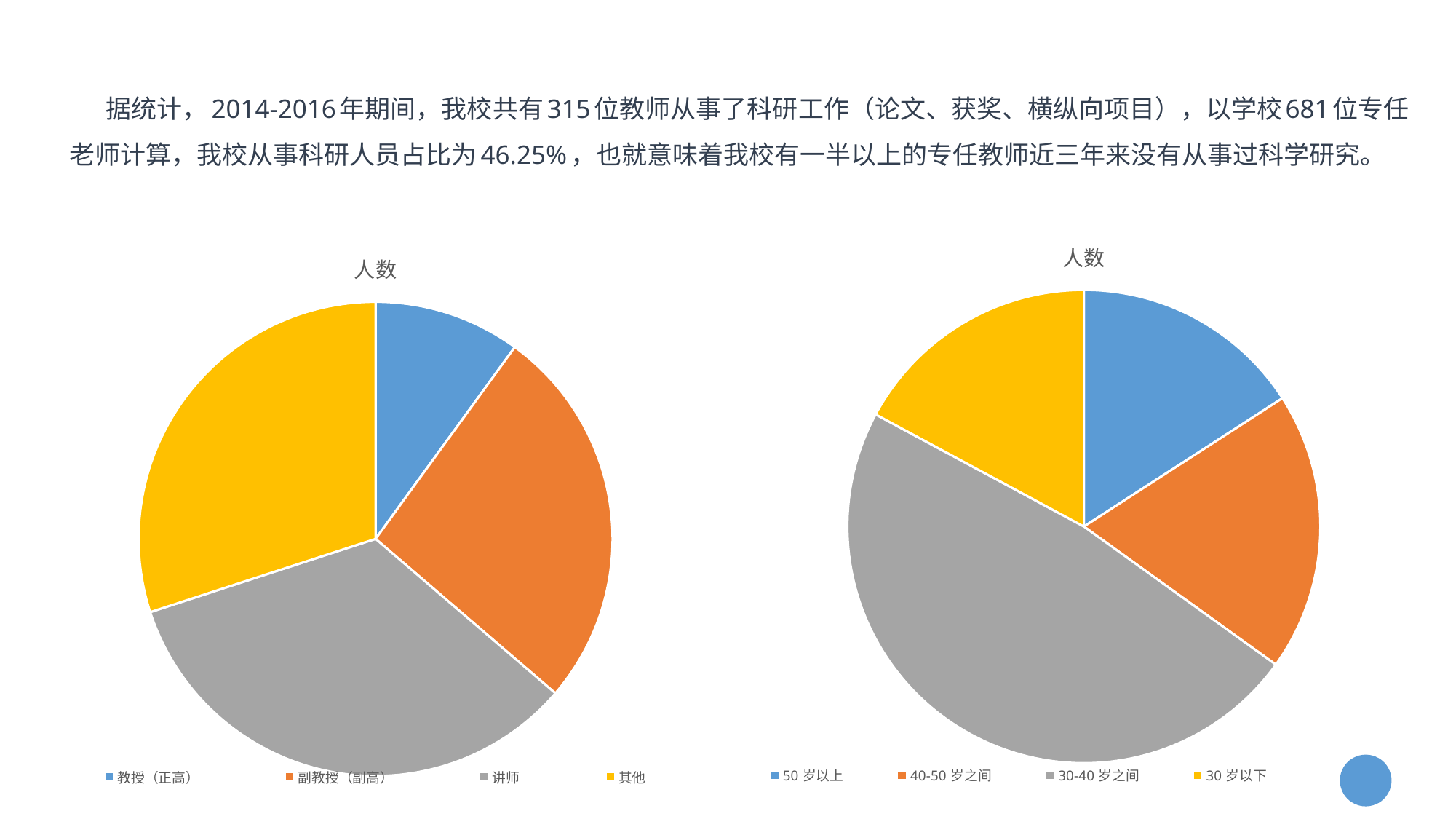
In the left pie chart, how many slices (categories) are there? 4 In the left pie chart, which slice is larger: 副教授（副高） or 教授（正高）? 副教授（副高） In the right pie chart, which category is shown in gray? 30-40 岁之间 What kind of chart is the right chart on the slide? pie chart In the right pie chart, how many slices (categories) are there? 4 In the left pie chart, which category has the smallest slice? 教授（正高） What kind of chart is the left chart on the slide? pie chart In the right pie chart, which slice is larger: 40-50 岁之间 or 50 岁以上? 40-50 岁之间 What is the title of the left pie chart? 人数 In the right pie chart, which slice is larger: 30-40 岁之间 or 40-50 岁之间? 30-40 岁之间 In the right pie chart, which category has the largest slice? 30-40 岁之间